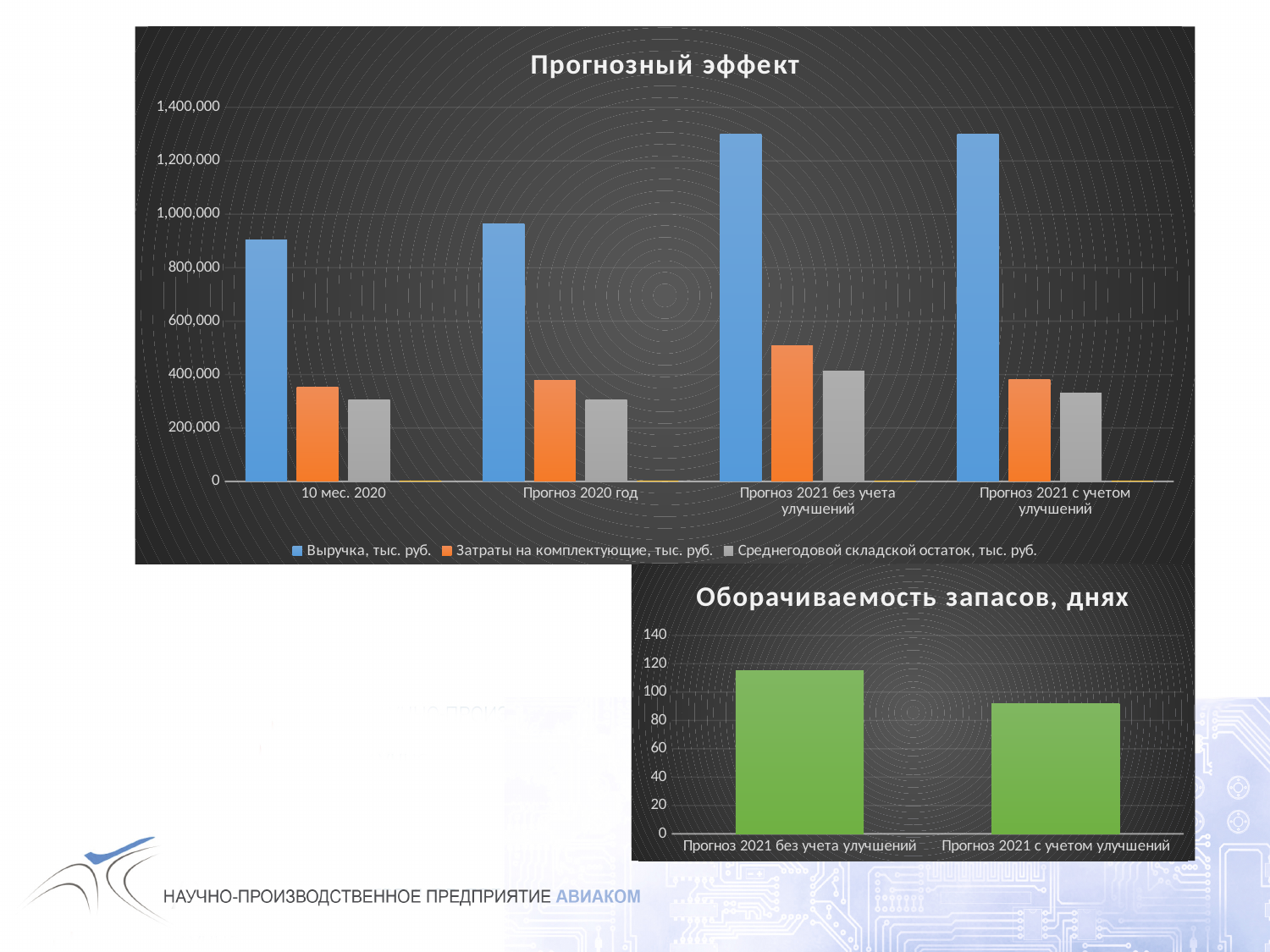
In the "Прогнозный эффект" chart, is the value of "Затраты на комплектующие, тыс. руб." for "Прогноз 2021 без учета улучшений" greater or less than 400,000? greater In the "Прогнозный эффект" chart, is the value of "Выручка, тыс. руб." for "Прогноз 2021 без учета улучшений" greater or less than 1,200,000? greater What kind of chart is the "Прогнозный эффект" chart? bar chart In the "Прогнозный эффект" chart, which category has the highest value of "Затраты на комплектующие, тыс. руб."? Прогноз 2021 без учета улучшений In the "Оборачиваемость запасов, днях" chart, is the value for "Прогноз 2021 без учета улучшений" greater or less than 100? greater How many series does the legend of the "Прогнозный эффект" chart list? 3 How many categories are shown on the x axis of the "Прогнозный эффект" chart? 4 In the "Прогнозный эффект" chart, which is larger for "Прогноз 2021 с учетом улучшений": "Затраты на комплектующие, тыс. руб." or "Среднегодовой складской остаток, тыс. руб."? Затраты на комплектующие, тыс. руб. In the "Прогнозный эффект" chart, which series is shown in blue? Выручка, тыс. руб. What kind of chart is the "Оборачиваемость запасов, днях" chart? bar chart In the "Оборачиваемость запасов, днях" chart, which category has the lowest value? Прогноз 2021 с учетом улучшений